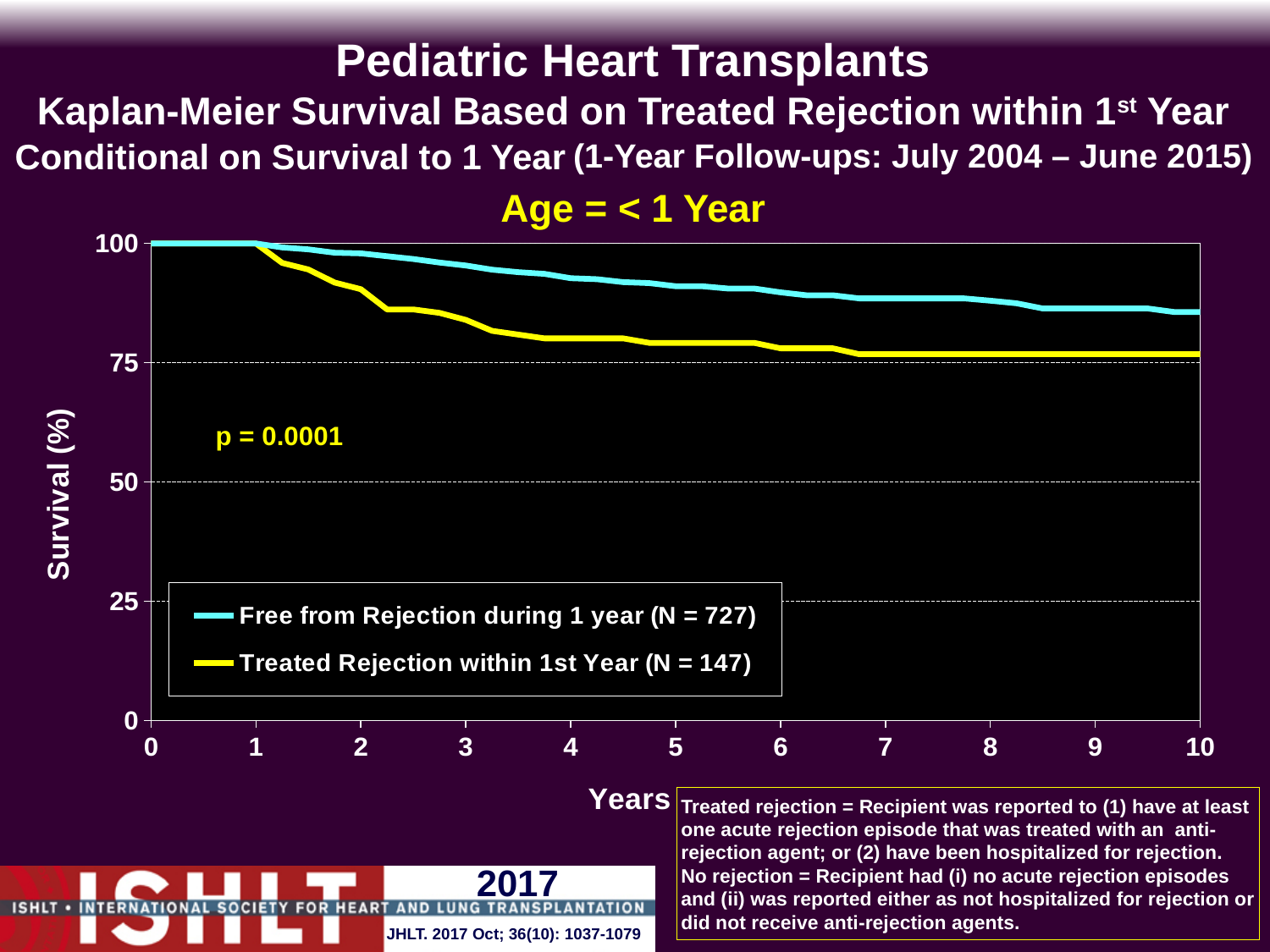
Is the survival for the Treated Rejection within 1st Year group at 3 years greater or less than 75? greater What is the label of the y-axis? Survival (%) What age group does the chart subtitle indicate? Age = < 1 Year What kind of chart is shown on the slide? Line chart Which group has higher survival at 5 years: Free from Rejection during 1 year or Treated Rejection within 1st Year? Free from Rejection during 1 year Is the survival for the Free from Rejection during 1 year group at 10 years greater or less than 75? greater What p-value is printed on the chart? p = 0.0001 What is the N for the 'Treated Rejection within 1st Year' group? 147 What is the N for the 'Free from Rejection during 1 year' group? 727 Is the survival for the Treated Rejection within 1st Year group at 5 years greater or less than 100? less How many series does the legend list? 2 Do the survival curves rise or fall as years increase? Fall